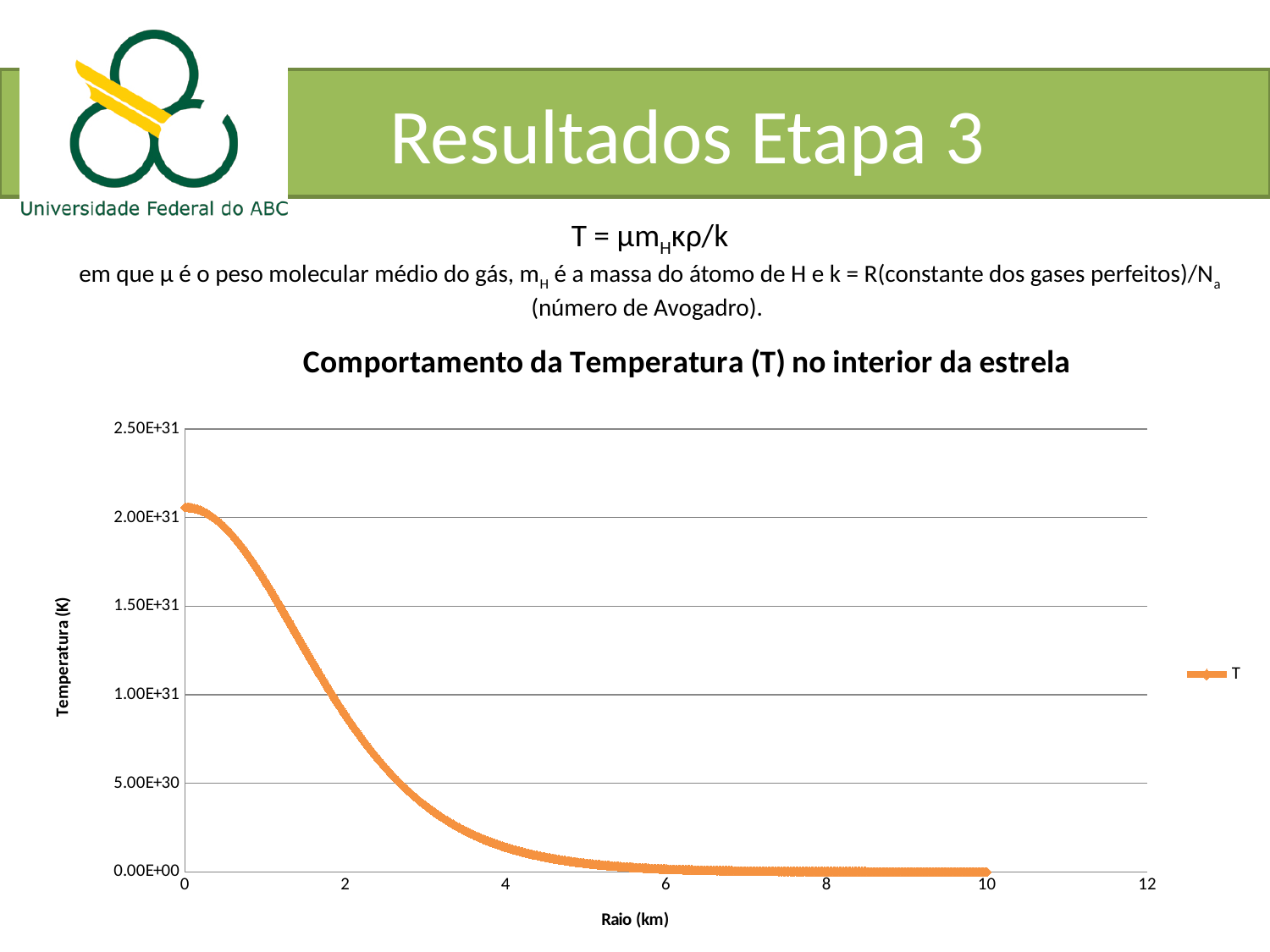
At which end of the radius axis is the temperature highest, near 0 km or near 10 km? near 0 km Does the temperature rise or fall as the radius increases along the x axis? fall What kind of chart is shown on the slide? line chart Is the temperature at radius 0 km greater or less than 1.50E+31? greater How many series does the chart legend list? 1 Is the temperature at radius 4 km greater or less than 5.00E+30? less Is the temperature at radius 8 km greater or less than 5.00E+30? less Which radius has the higher temperature, 1 km or 5 km? 1 km What is the title of the chart? Comportamento da Temperatura (T) no interior da estrela What is the name of the series shown in the legend? T